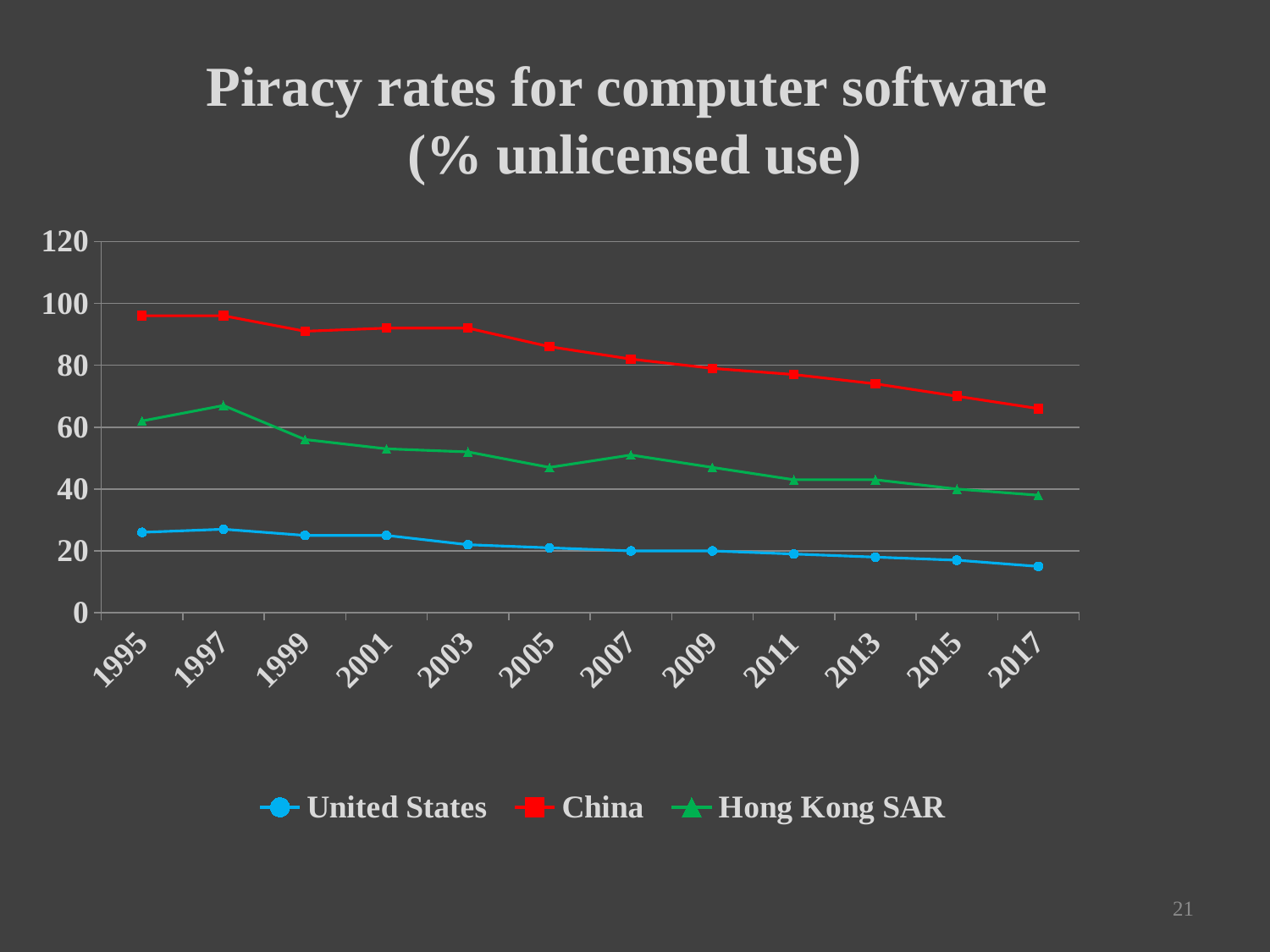
How many years are plotted along the x axis? 12 Is the value for Hong Kong SAR in 1997 greater or less than 60? greater Is the value for the United States in 2017 greater or less than 20? less What is the title of the chart? Piracy rates for computer software (% unlicensed use) How many series does the legend list? 3 Does the piracy rate for the United States rise or fall from 1995 to 2017? fall Does the piracy rate for China rise or fall from 1995 to 2017? fall Is the value for China in 1995 greater or less than 80? greater What kind of chart is shown on the slide? line chart In 2005, which is larger: the value for China or the value for Hong Kong SAR? China Which series has the lowest piracy rate in every year shown? United States Which series has the highest piracy rate in every year shown? China